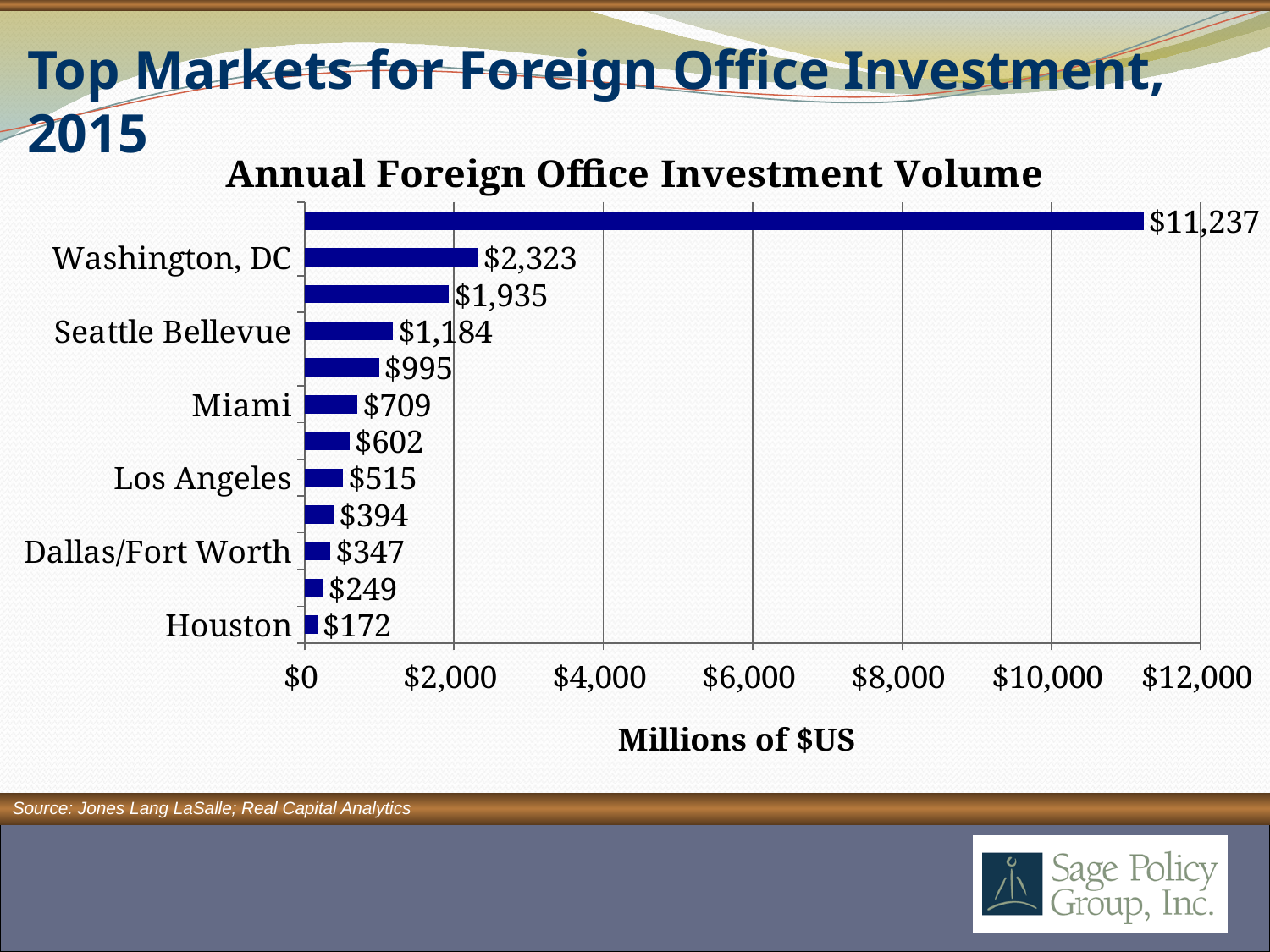
What is the annual foreign office investment volume for Washington, DC? $2,323 What is the value shown for Dallas/Fort Worth? $347 What is the value shown for Los Angeles? $515 What is the largest value labeled on any bar in the chart? $11,237 What kind of chart is shown on the slide? Bar chart What is the value shown for Seattle Bellevue? $1,184 What is the difference between the values for Washington, DC and Seattle Bellevue? $1,139 Which has a larger value, Miami or Los Angeles? Miami How many bars are plotted in the chart? 12 Which labeled market has the lowest foreign office investment volume? Houston What is the value shown for Miami? $709 What is the x-axis label of the chart? Millions of $US